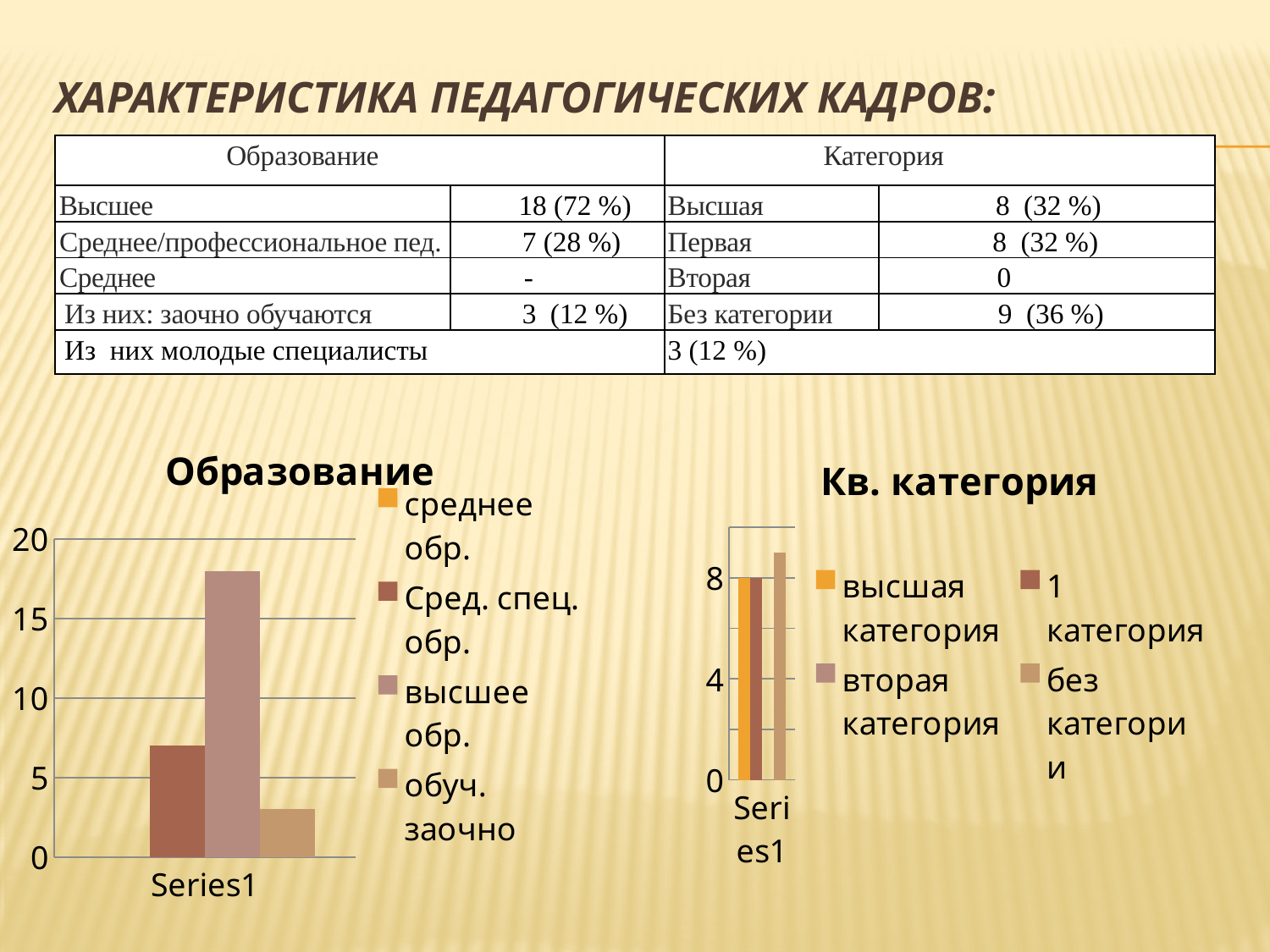
In the "Образование" chart, which series has the tallest bar? высшее обр. In the "Образование" chart, is the value for высшее обр. greater or less than 15? greater How many series does the legend of the "Образование" chart list? 4 How many series does the legend of the "Кв. категория" chart list? 4 In the "Образование" chart, which is larger: Сред. спец. обр. or обуч. заочно? Сред. спец. обр. In the "Кв. категория" chart, which series has the tallest bar? без категории In the "Кв. категория" chart, is the value for без категории greater or less than 8? greater What kind of chart is the "Кв. категория" chart? bar chart In the "Образование" chart, is the value for обуч. заочно greater or less than 5? less What is the title of the chart on the right side of the slide? Кв. категория What kind of chart is the "Образование" chart? bar chart In the "Кв. категория" chart, what is the value for высшая категория? 8